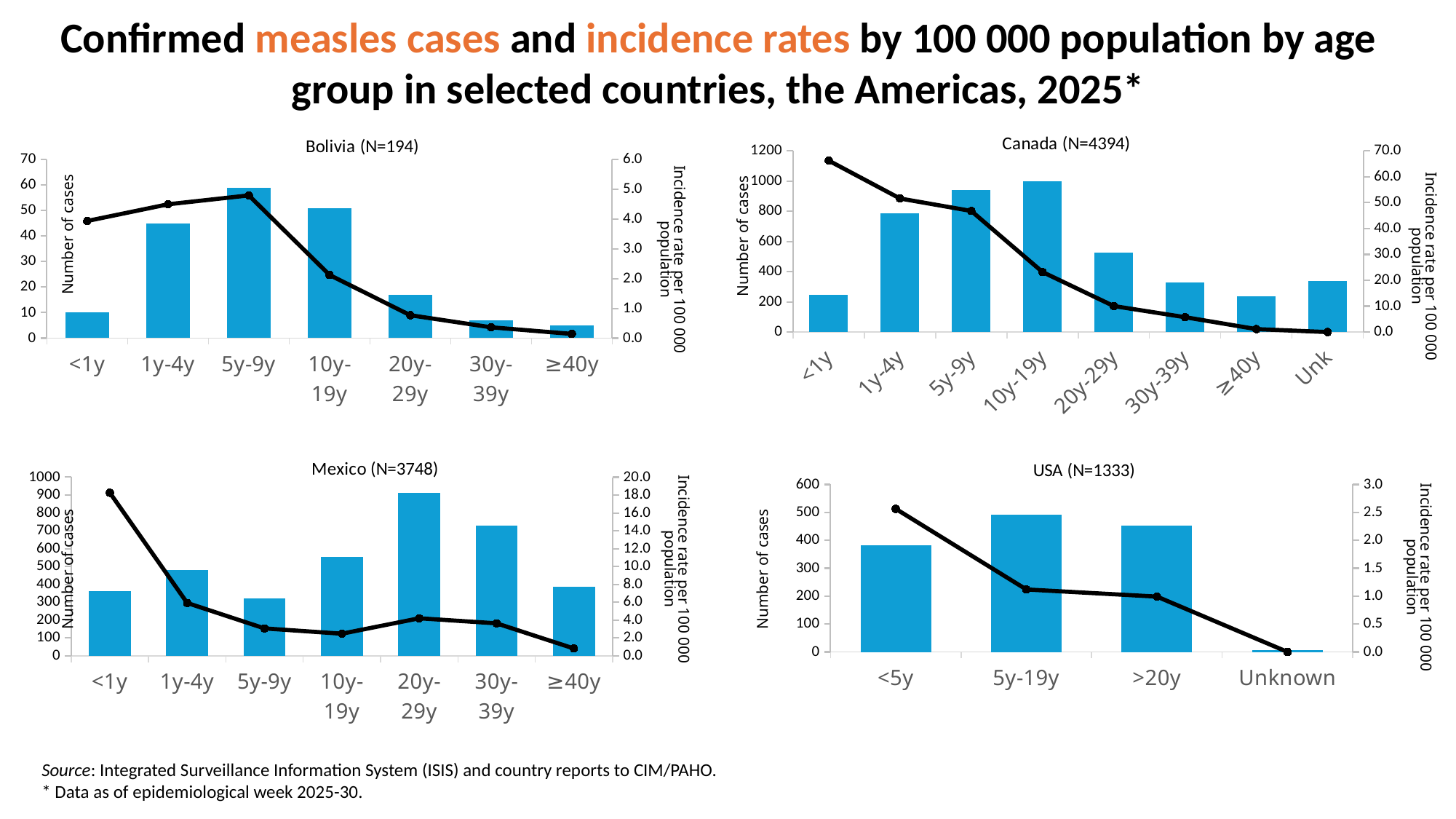
In the Bolivia (N=194) chart, which age group has the highest number of cases? 5y-9y In the Canada (N=4394) chart, which age group has the highest number of cases? 10y-19y In the Mexico (N=3748) chart, is the number of cases for 20y-29y greater or less than 800? greater In the Mexico (N=3748) chart, which age group has the highest number of cases? 20y-29y In the Canada (N=4394) chart, is the incidence rate for <1y greater or less than 60.0? greater In the USA (N=1333) chart, which age group has the lowest number of cases? Unknown How many age-group categories are shown in the Canada (N=4394) chart? 8 How many age-group categories are shown in the USA (N=1333) chart? 4 In the Mexico (N=3748) chart, which has more cases, 30y-39y or 10y-19y? 30y-39y In the USA (N=1333) chart, does the incidence rate line rise or fall from <5y to Unknown? fall What kind of chart is the Bolivia (N=194) chart? Combined bar and line chart In the Bolivia (N=194) chart, is the number of cases for 5y-9y greater or less than 50? greater